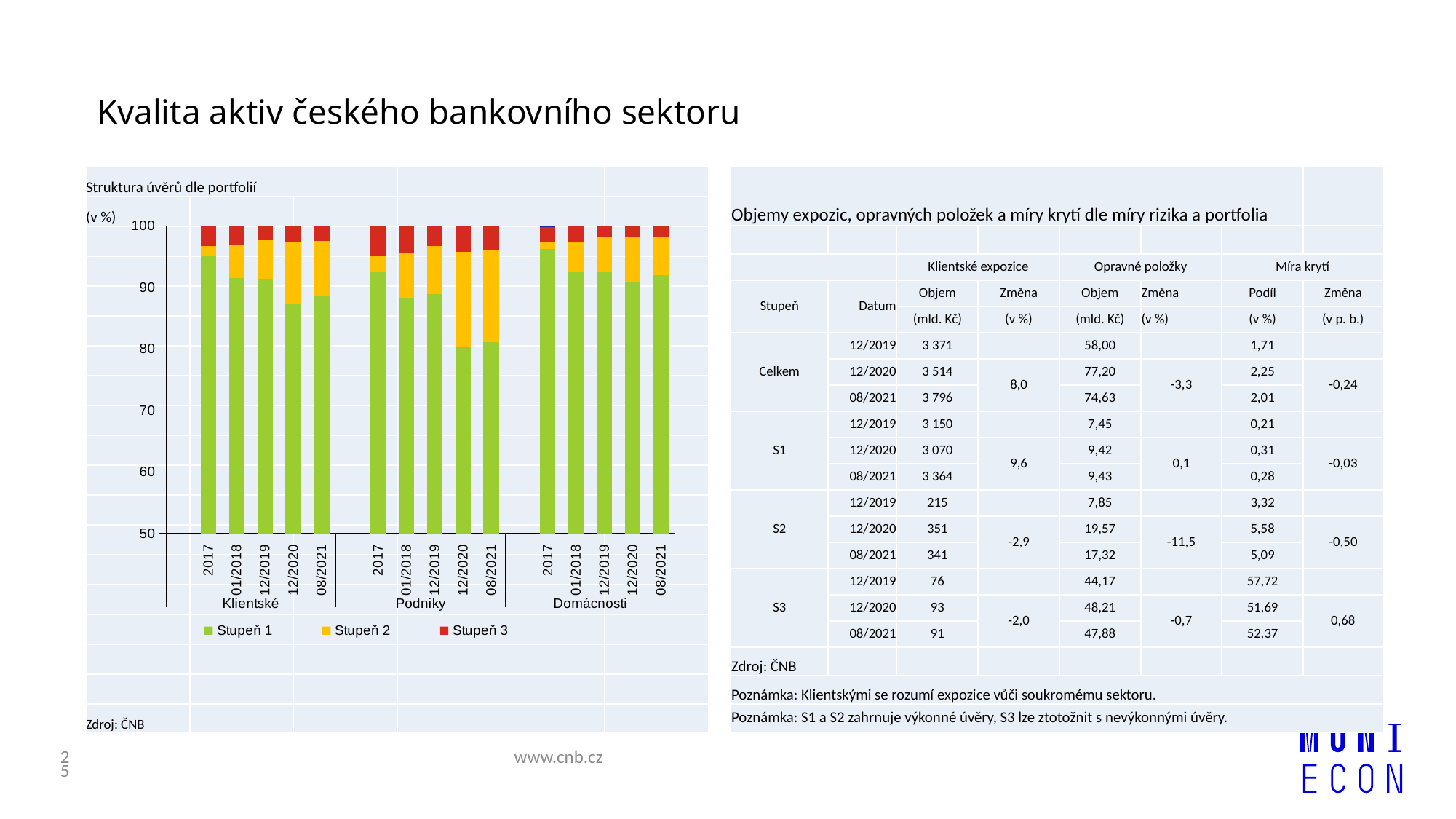
In the chart 'Struktura úvěrů dle portfolií', which is larger: the Stupeň 2 share for Podniky in 12/2020 or for Klientské in 2017? Podniky in 12/2020 In the chart 'Struktura úvěrů dle portfolií', is the Stupeň 1 value for Domácnosti in 2017 greater or less than 90? greater What is the title of the chart on the left of the slide? Struktura úvěrů dle portfolií How many portfolio groups are shown on the x axis of the chart 'Struktura úvěrů dle portfolií'? 3 In the chart 'Struktura úvěrů dle portfolií', is the Stupeň 1 value for Klientské in 12/2020 greater or less than 90? less In the chart 'Struktura úvěrů dle portfolií', is the Stupeň 1 value for Podniky in 12/2020 greater or less than 90? less In the chart 'Struktura úvěrů dle portfolií', which is larger: the Stupeň 1 share for Klientské in 2017 or for Podniky in 12/2020? Klientské in 2017 How many series does the legend of the chart 'Struktura úvěrů dle portfolií' list? 3 How many bars are plotted in total in the chart 'Struktura úvěrů dle portfolií'? 15 In the chart 'Struktura úvěrů dle portfolií', does the Stupeň 1 share for Podniky rise or fall from 2017 to 12/2020? fall What kind of chart is shown on the left of the slide? Stacked bar chart